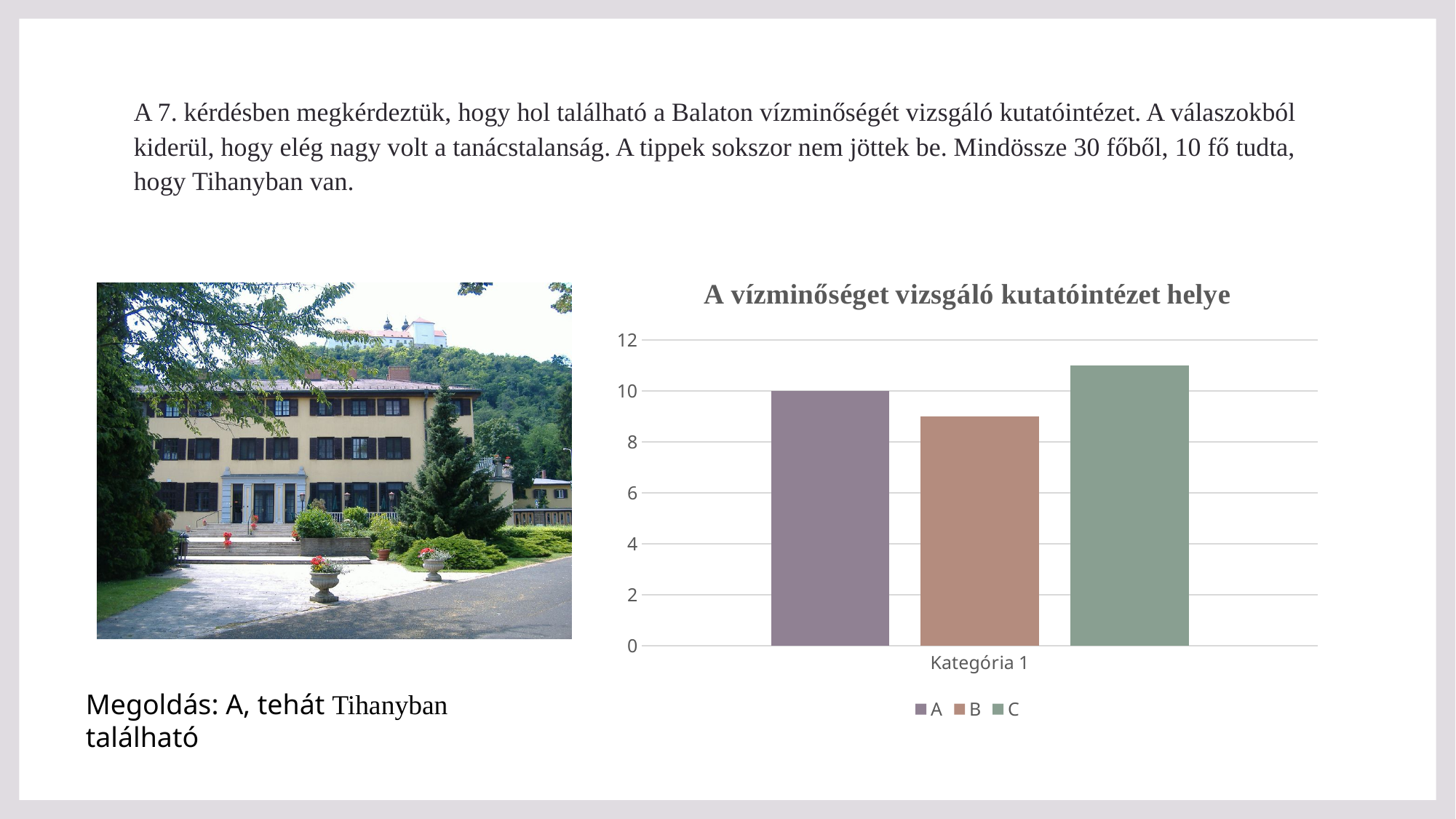
What kind of chart is shown on the slide? bar chart What is the label of the category on the x axis? Kategória 1 Is the value for series B greater or less than 10? less Which is larger, the value for series A or series B? A What is the value for series A in Kategória 1? 10 Is the value for series B greater or less than 8? greater Is the value for series C greater or less than 10? greater How many categories are shown on the x axis? 1 What is the title of the chart? A vízminőséget vizsgáló kutatóintézet helye How many series does the legend list? 3 Which series has the lowest value? B Which series has the highest value? C